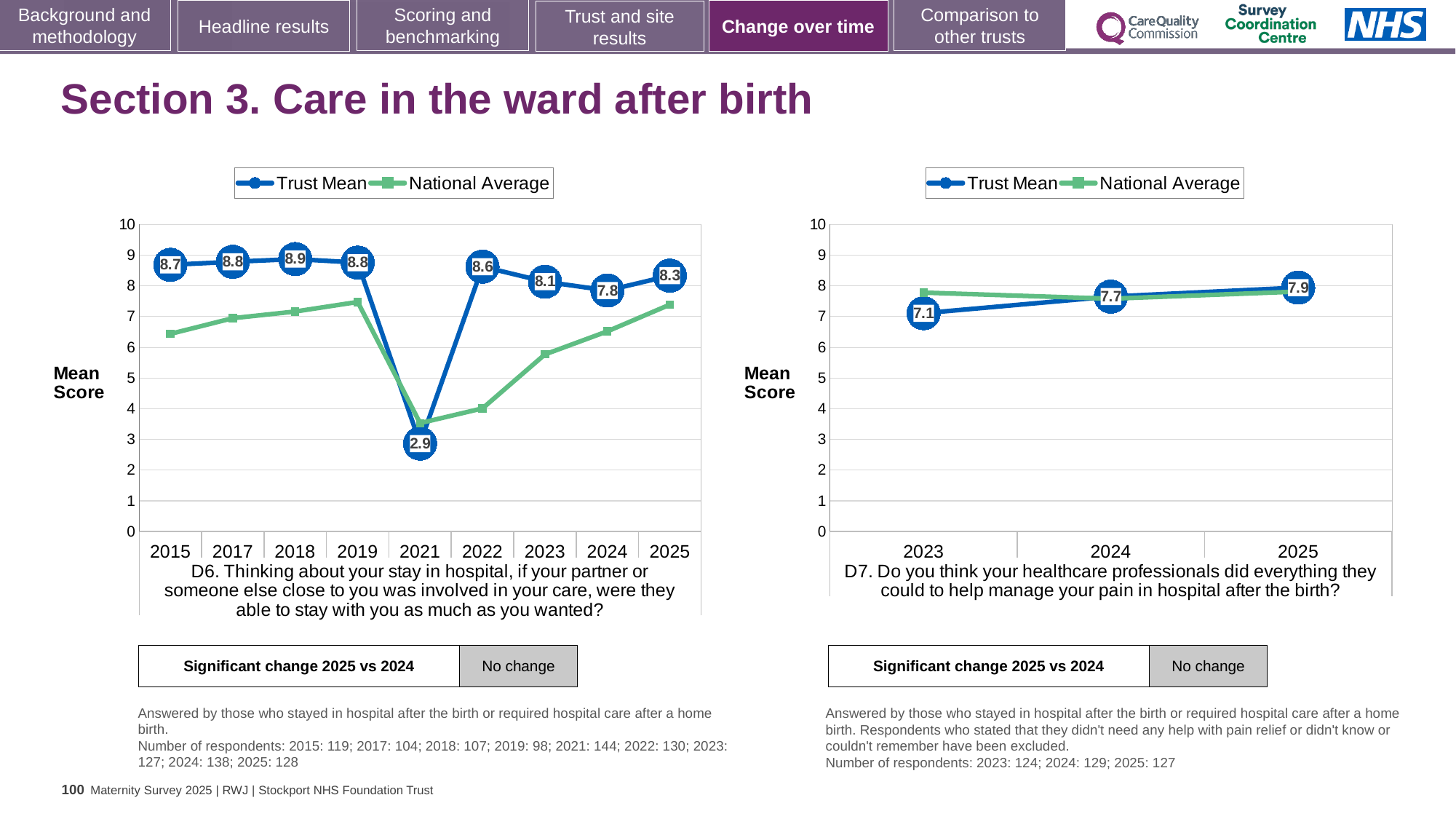
In the D6 chart on the left, what is the Trust Mean score for 2025? 8.3 In the D6 chart on the left, is the National Average value for 2015 greater or less than 7? less In the D7 chart on the right, does the Trust Mean rise or fall from 2023 to 2025? rise In the D6 chart on the left, what is the difference between the Trust Mean scores for 2022 and 2021? 5.7 In the D6 chart on the left, how many years are shown on the x axis? 9 What kind of chart is the D7 chart on the right? line chart In the D6 chart on the left, which year has the lowest Trust Mean score? 2021 In the D7 chart on the right, how many series does the legend list? 2 In the D6 chart on the left, what is the Trust Mean score for 2021? 2.9 In the D6 chart on the left, which year has the highest Trust Mean score? 2018 In the D7 chart on the right, what is the Trust Mean score for 2023? 7.1 In the D7 chart on the right, what is the difference between the Trust Mean scores for 2025 and 2023? 0.8